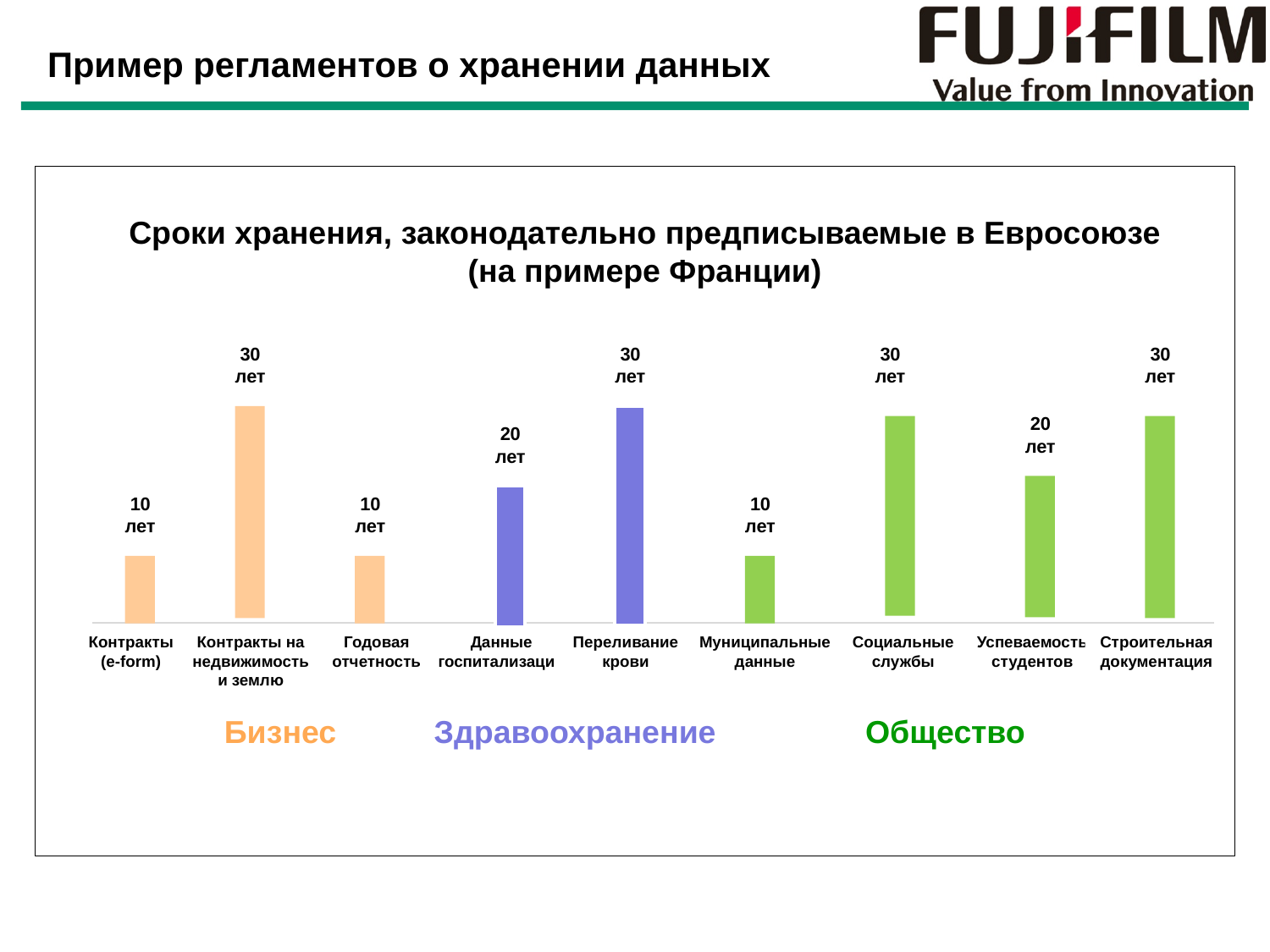
What is the retention period shown for Контракты (e-form)? 10 лет Which has a longer retention period, Социальные службы or Муниципальные данные? Социальные службы What kind of chart is shown on the slide? Bar chart How many categories are shown in the chart? 9 Which has a longer retention period, Переливание крови or Данные госпитализаци? Переливание крови Which sector group do the blue bars represent? Здравоохранение How many categories have a retention period of 30 лет? 4 What is the retention period shown for Данные госпитализаци? 20 лет What is the retention period shown for Муниципальные данные? 10 лет What is the retention period shown for Контракты на недвижимость и землю? 30 лет What is the retention period shown for Успеваемость студентов? 20 лет What is the difference between the retention periods for Контракты на недвижимость и землю and Контракты (e-form)? 20 лет